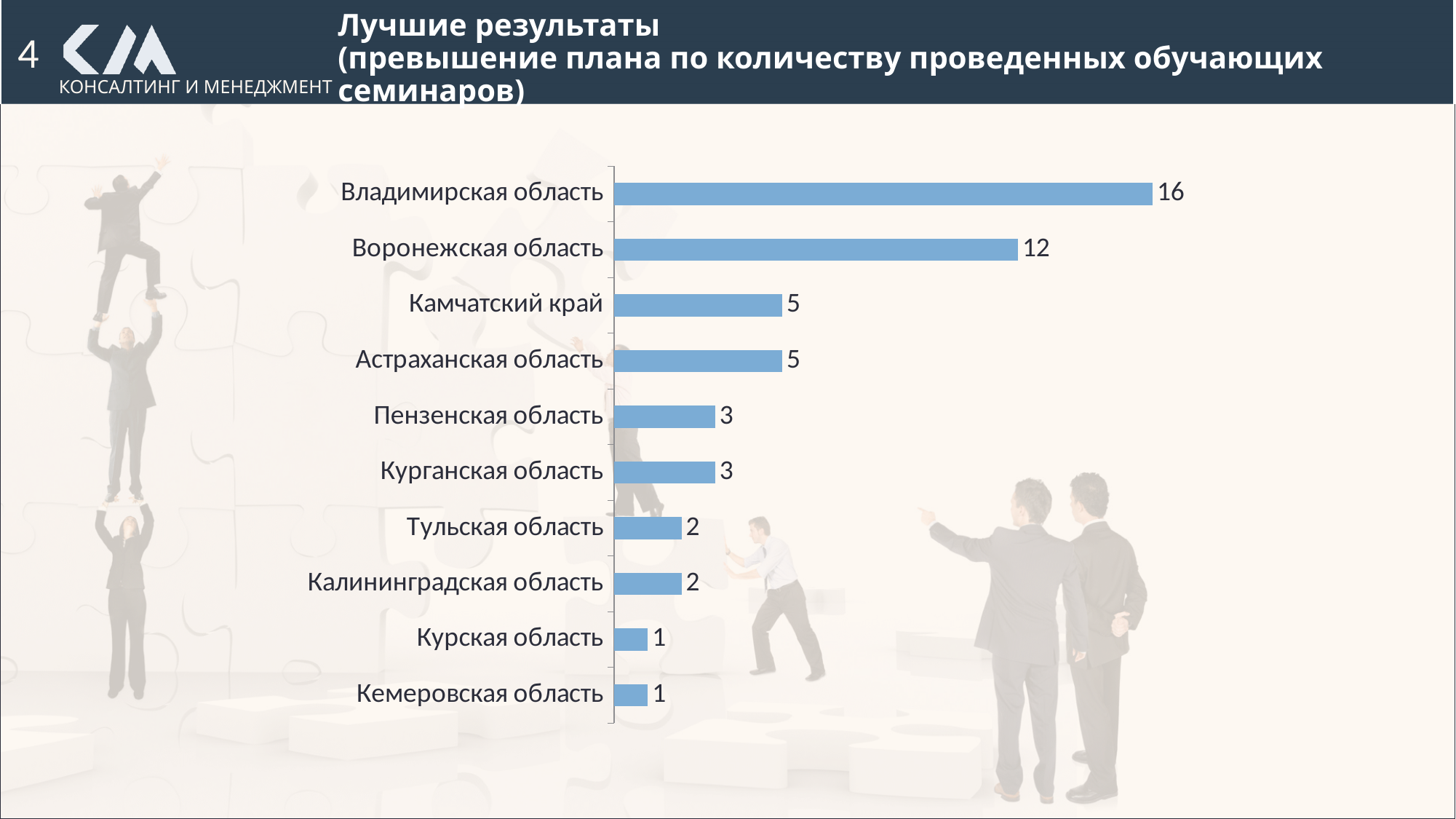
What is the value for Воронежская область? 12 What is the value for Калининградская область? 2 What is the value for Тульская область? 2 What is the difference between the values for Астраханская область and Кемеровская область? 4 What is the difference between the values for Владимирская область and Воронежская область? 4 What is the value for Владимирская область? 16 What is the value for Камчатский край? 5 How many regions are shown in the chart? 10 Which region has the highest value? Владимирская область What colour are the bars in the chart? Blue What kind of chart is shown on the slide? Bar chart Which is larger, the value for Пензенская область or the value for Курская область? Пензенская область